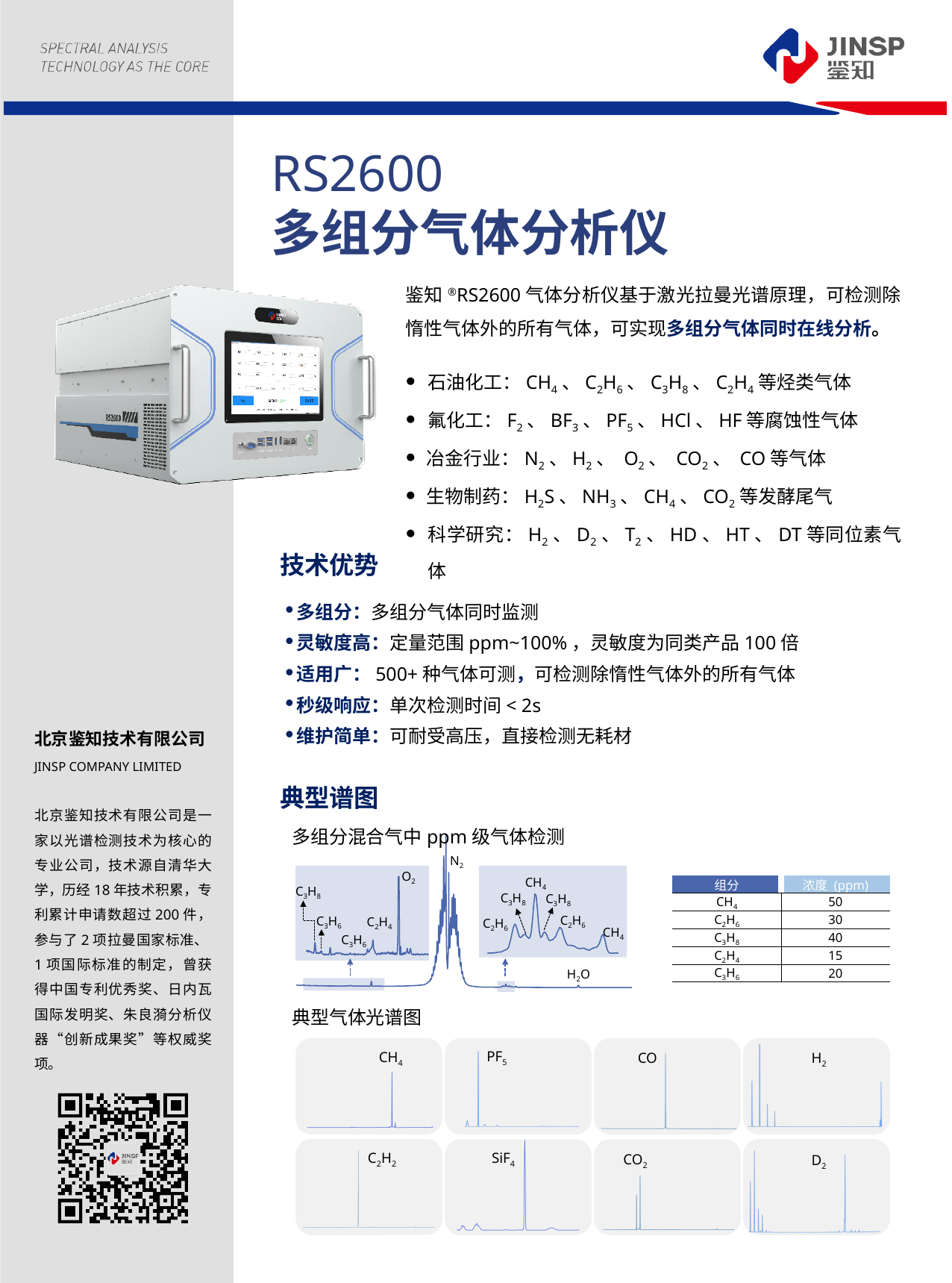
In the concentration table beside the mixed-gas spectrum, what is the total of all five listed concentrations in ppm? 155 How many components are listed in the concentration table beside the mixed-gas spectrum? 5 In the '多组分混合气中 ppm 级气体检测' spectrum, which gas is labeled at the tallest central peak? N2 In the concentration table beside the mixed-gas spectrum, what is the concentration (ppm) listed for C2H4? 15 What kind of chart is the '多组分混合气中 ppm 级气体检测' spectrum? line chart In the concentration table beside the mixed-gas spectrum, which has the larger concentration, C3H8 or C2H6? C3H8 In the concentration table beside the mixed-gas spectrum, which component has the lowest concentration? C2H4 Which gas is labeled in the top-right panel of the '典型气体光谱图' grid? H2 In the table next to the spectrum chart '多组分混合气中 ppm 级气体检测', what is the concentration (ppm) listed for CH4? 50 How many individual gas spectra panels are shown under '典型气体光谱图'? 8 In the concentration table beside the mixed-gas spectrum, which component has the highest concentration? CH4 In the concentration table beside the mixed-gas spectrum, what is the difference in ppm between the CH4 and C2H6 concentrations? 20